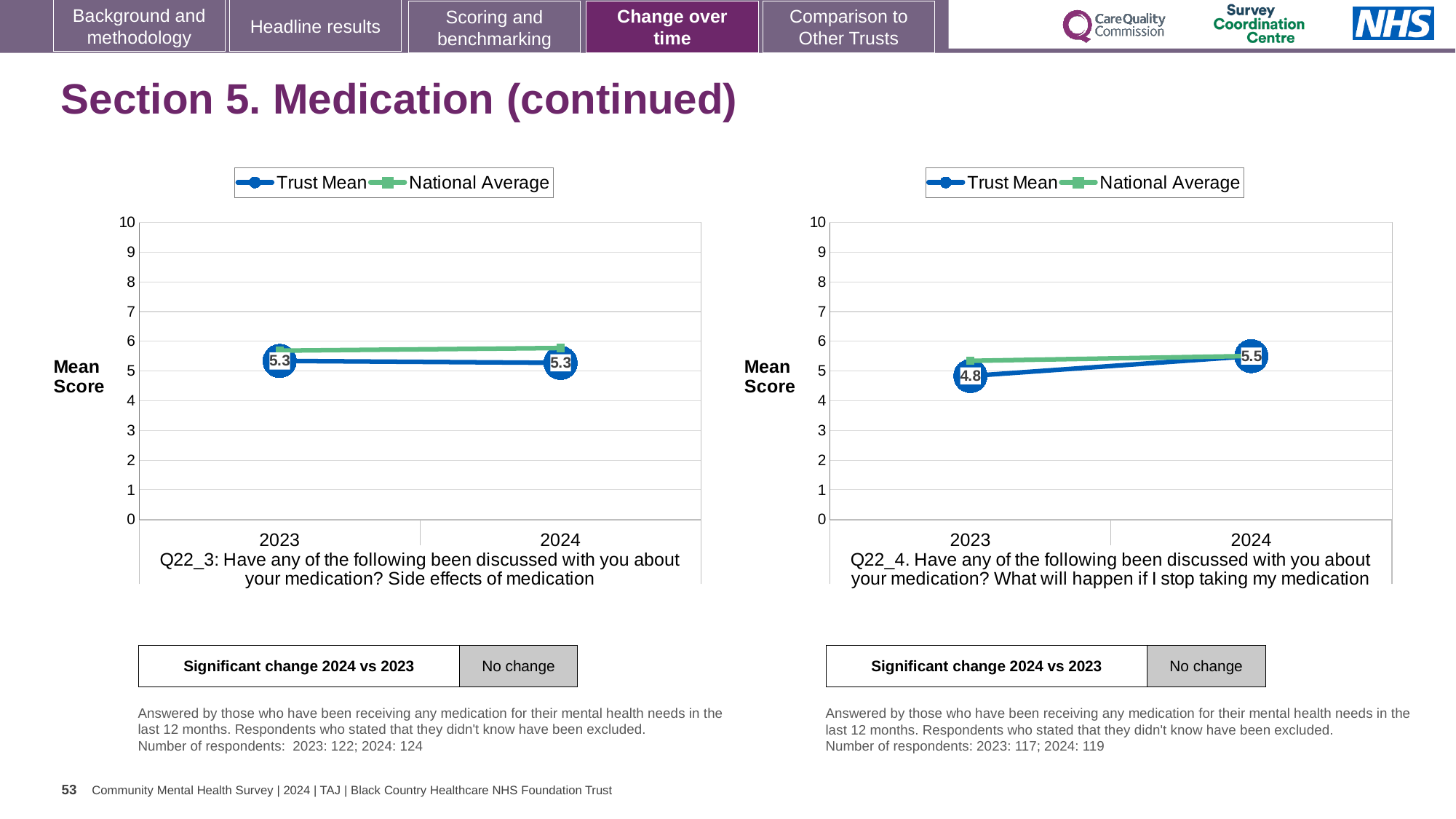
How many series does the legend of the right chart (Q22_4) list? 2 In the right chart (Q22_4), what is the Trust Mean for 2023? 4.8 In the left chart (Q22_3), what is the Trust Mean for 2023? 5.3 What kind of chart is the left chart (Q22_3)? line chart What is the maximum value shown on the y axis of the right chart (Q22_4)? 10 In the right chart (Q22_4), is the National Average for 2023 greater or less than 5? greater In the left chart (Q22_3), what is the Trust Mean for 2024? 5.3 In the right chart (Q22_4), by how much did the Trust Mean change from 2023 to 2024? 0.7 In the right chart (Q22_4), what is the Trust Mean for 2024? 5.5 In the right chart (Q22_4), does the Trust Mean rise or fall from 2023 to 2024? rise In the left chart (Q22_3), which is larger in 2023, the Trust Mean or the National Average? National Average How many years are shown on the x axis of the left chart (Q22_3)? 2